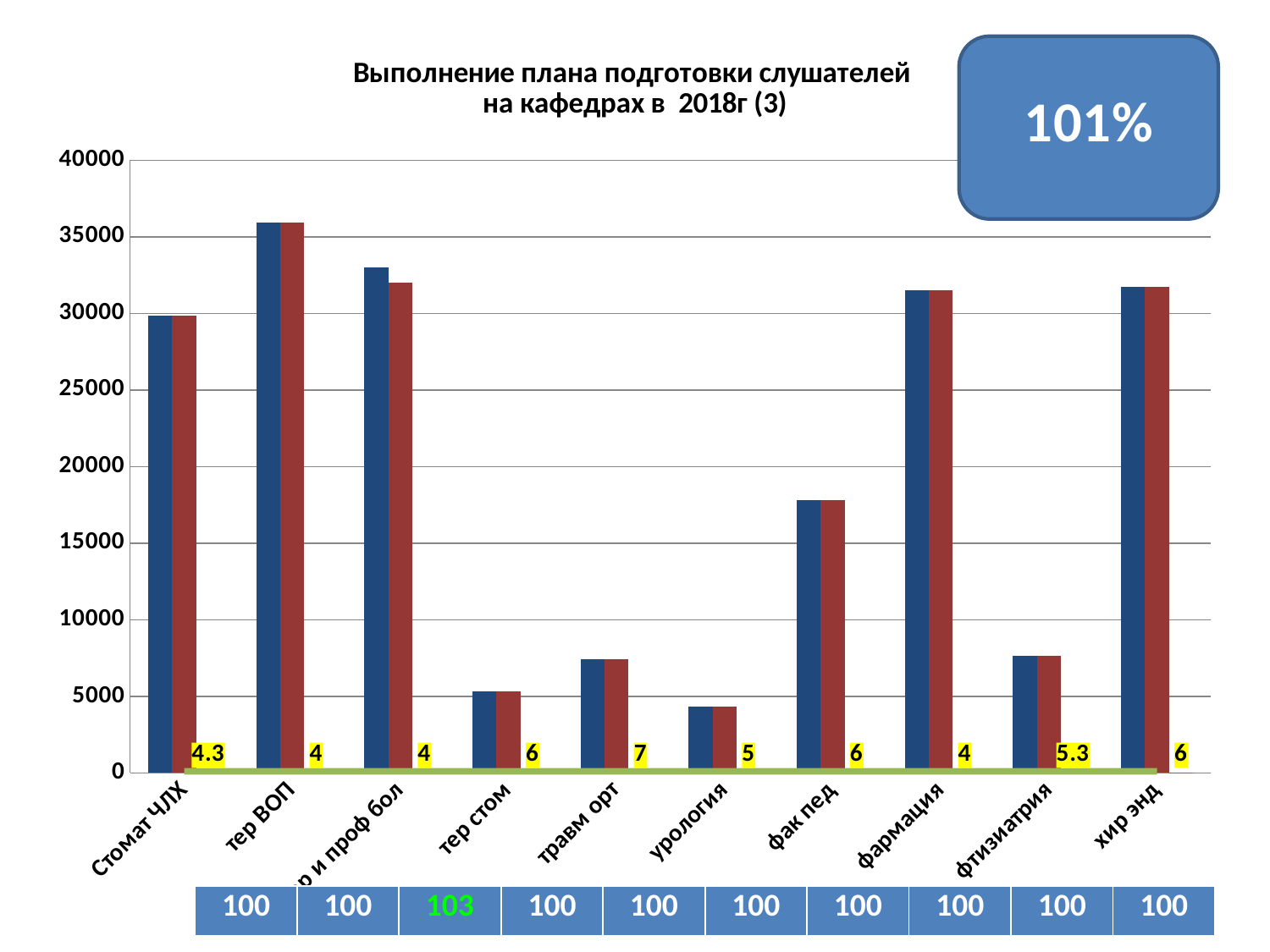
What value is labelled on the green line for травм орт? 7 Which category has taller bars, фак пед or тер стом? фак пед Which category has the shortest bars in the chart? урология Is the value of the blue bar for урология greater or less than 5000? less Is the value of the blue bar for тер ВОП greater or less than 35000? greater What value is labelled on the green line for фтизиатрия? 5.3 Is the value of the blue bar for фак пед greater or less than 15000? greater What percentage is shown in the rounded box at the top right of the slide? 101% How many categories are shown along the x axis of the chart? 10 What kind of chart is shown on the slide? bar chart Which category has the tallest bars in the chart? тер ВОП Which category has taller bars, тер ВОП or фармация? тер ВОП